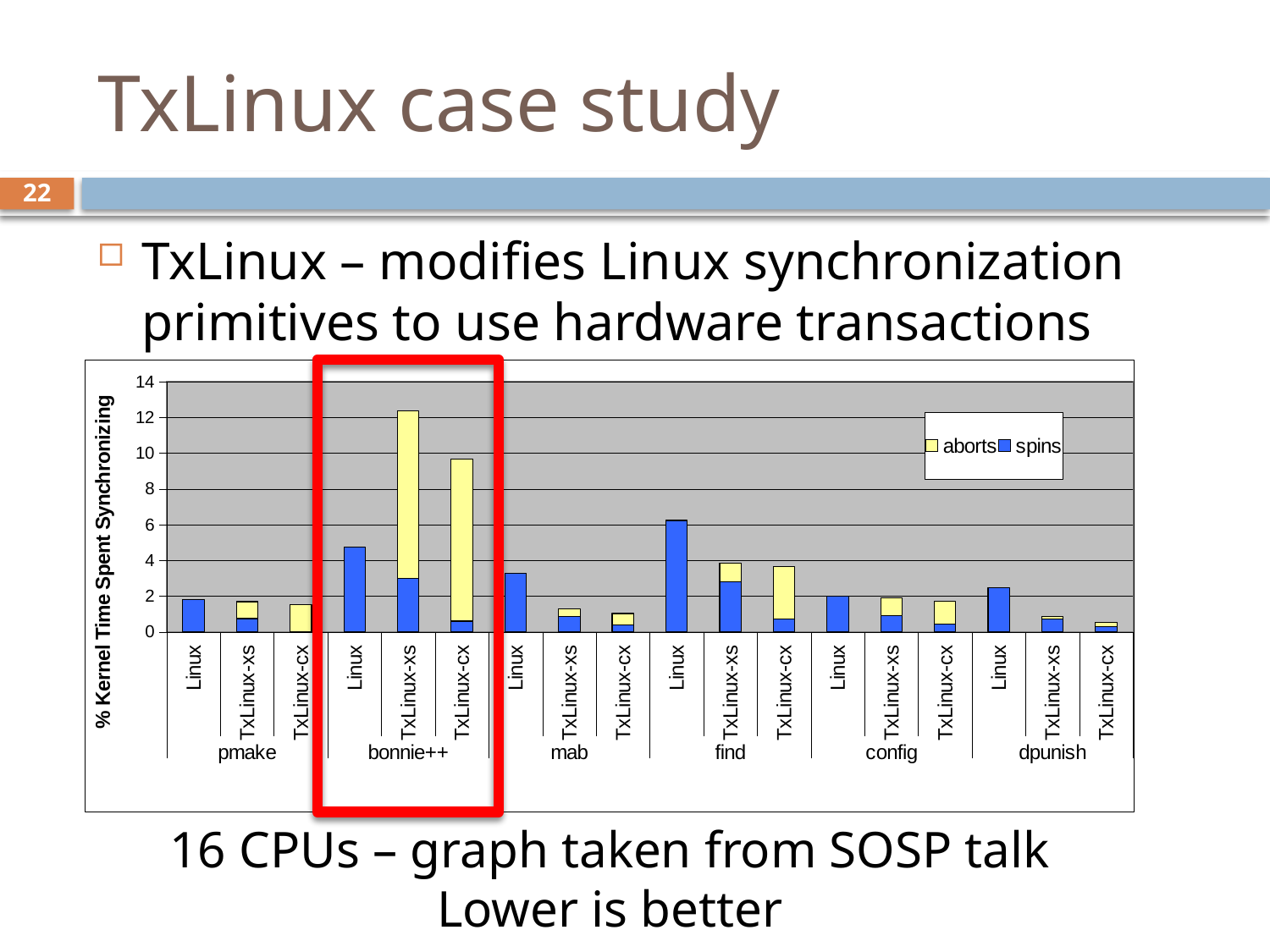
Is the value for TxLinux-xs under bonnie++ greater or less than 10? greater What kind of chart is shown on the slide? stacked bar chart Is the value for Linux under mab greater or less than 2? greater How many series does the chart legend list? 2 How many bars are plotted in the chart in total? 18 Under find, which bar is taller: Linux or TxLinux-xs? Linux Under bonnie++, which bar is taller: TxLinux-xs or TxLinux-cx? TxLinux-xs Which bar in the chart is the tallest? TxLinux-xs for bonnie++ What is the label of the vertical axis of the chart? % Kernel Time Spent Synchronizing What are the two series named in the chart legend? aborts and spins Is the value for Linux under bonnie++ greater or less than 6? less How many benchmark groups are shown along the x axis of the chart? 6